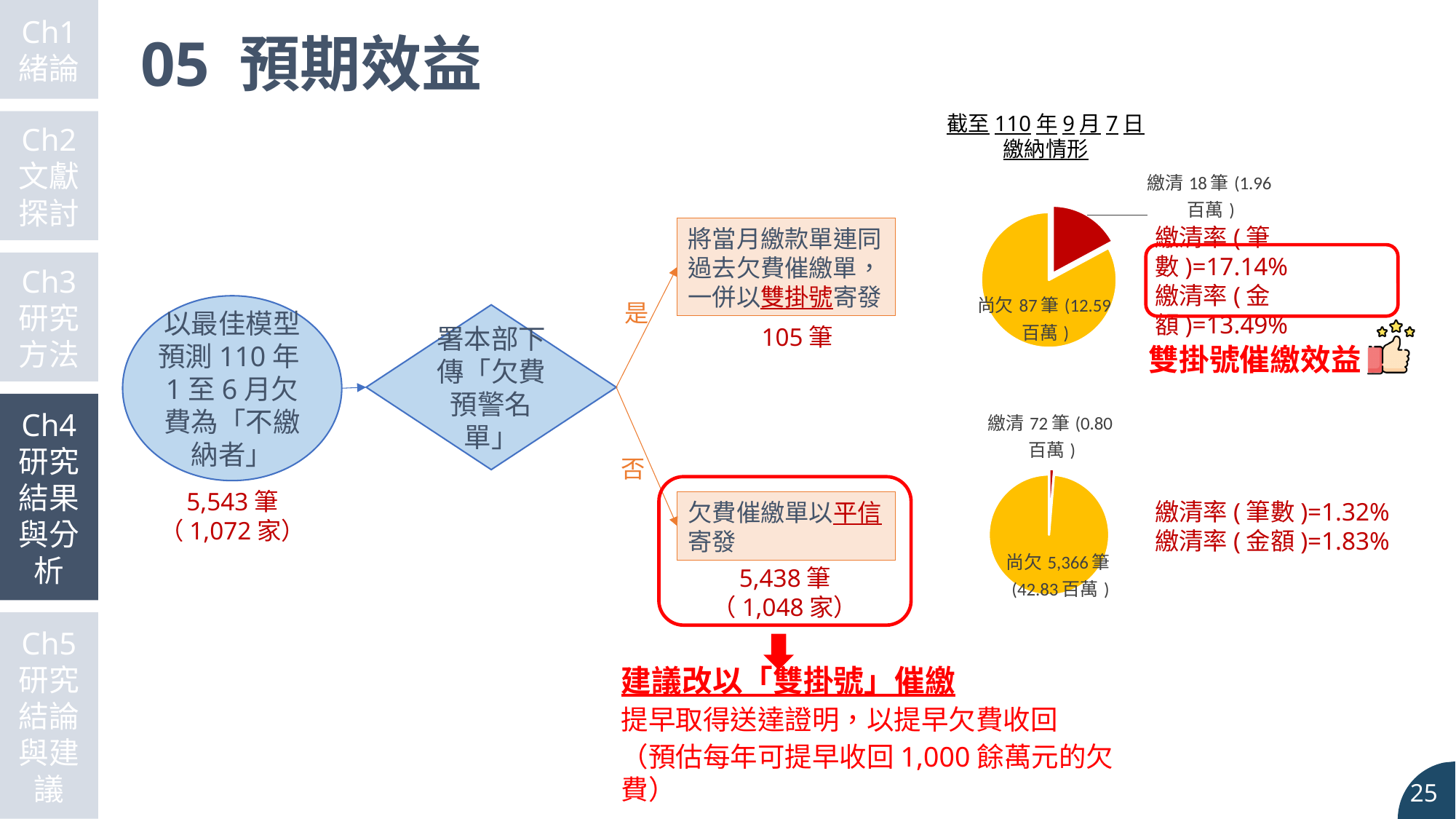
In the upper pie chart, what share of 筆 does 繳清 represent, as printed on the slide (繳清率(筆數))? 17.14% In the upper pie chart, how many 筆 are labelled as 繳清? 18 筆 In the upper pie chart, which category has the larger slice? 尚欠 In the lower pie chart, which is larger in 筆 count: 繳清 or 尚欠? 尚欠 In the lower pie chart, what amount (百萬) is shown for 繳清? 0.80 百萬 In the lower pie chart, what is the total number of 筆 across 繳清 (72 筆) and 尚欠 (5,366 筆)? 5,438 筆 In the lower pie chart, how many 筆 are labelled as 尚欠? 5,366 筆 How many slices does the upper pie chart have? 2 What kind of chart is the upper chart on the right side of the slide (截至110年9月7日繳納情形)? pie chart In the upper pie chart, what is the difference in 筆 between 尚欠 (87 筆) and 繳清 (18 筆)? 69 筆 In the upper pie chart, what colour is the 繳清 slice? red In the upper pie chart, what amount (百萬) is shown for 尚欠? 12.59 百萬